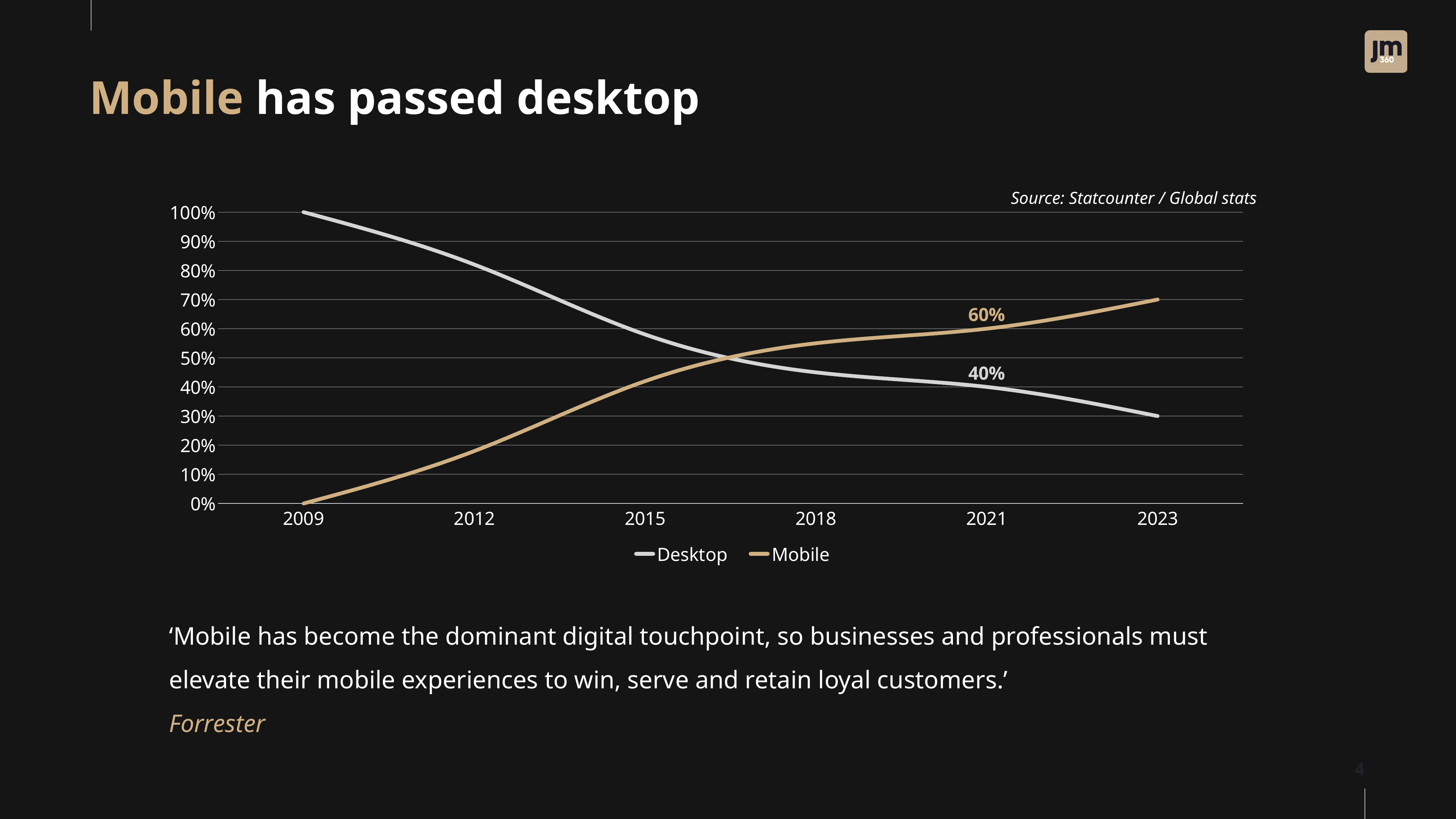
What source is cited for the chart? Statcounter / Global stats What is the value for Desktop in 2021? 40% What kind of chart is shown on the slide? Line chart How many series does the legend list? 2 Does the Desktop line rise or fall from 2009 to 2023? Falls Does the Mobile line rise or fall from 2009 to 2023? Rises Is the value for Mobile in 2018 greater or less than 50%? greater Is the value for Desktop in 2018 greater or less than 50%? less What is the difference between the Mobile and Desktop values in 2021? 20% How many years are labelled on the x axis? 6 What is the value for Mobile in 2021? 60% In 2021, which series has the larger value, Desktop or Mobile? Mobile